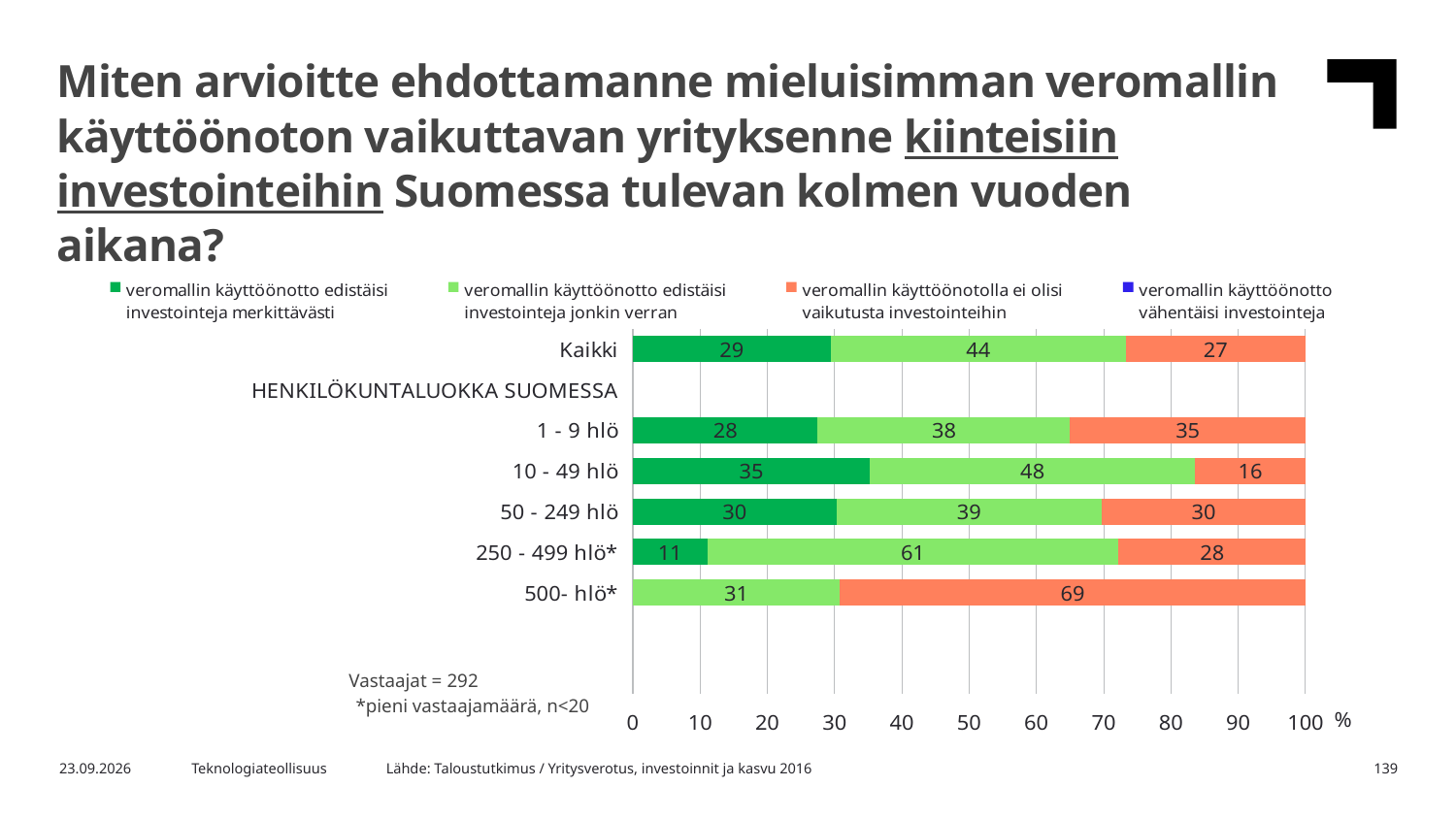
How many categories with data bars are shown in the chart? 6 How many series does the legend list? 4 What is the value of 'veromallin käyttöönotto edistäisi investointeja merkittävästi' for Kaikki? 29 What is the value of 'veromallin käyttöönotolla ei olisi vaikutusta investointeihin' for 500- hlö*? 69 What is the difference between the 'veromallin käyttöönotto edistäisi investointeja jonkin verran' values for 10 - 49 hlö and 1 - 9 hlö? 10 Which category has the highest value for 'veromallin käyttöönotto edistäisi investointeja merkittävästi'? 10 - 49 hlö Which category has the lowest value for 'veromallin käyttöönotolla ei olisi vaikutusta investointeihin'? 10 - 49 hlö What is the value of 'veromallin käyttöönotto edistäisi investointeja jonkin verran' for 250 - 499 hlö*? 61 What is the number of respondents (Vastaajat) stated on the slide? 292 What kind of chart is shown on the slide? Stacked bar chart Which is larger: the 'veromallin käyttöönotolla ei olisi vaikutusta investointeihin' value for 1 - 9 hlö or for Kaikki? 1 - 9 hlö What is the total of the stacked bar for 50 - 249 hlö? 99